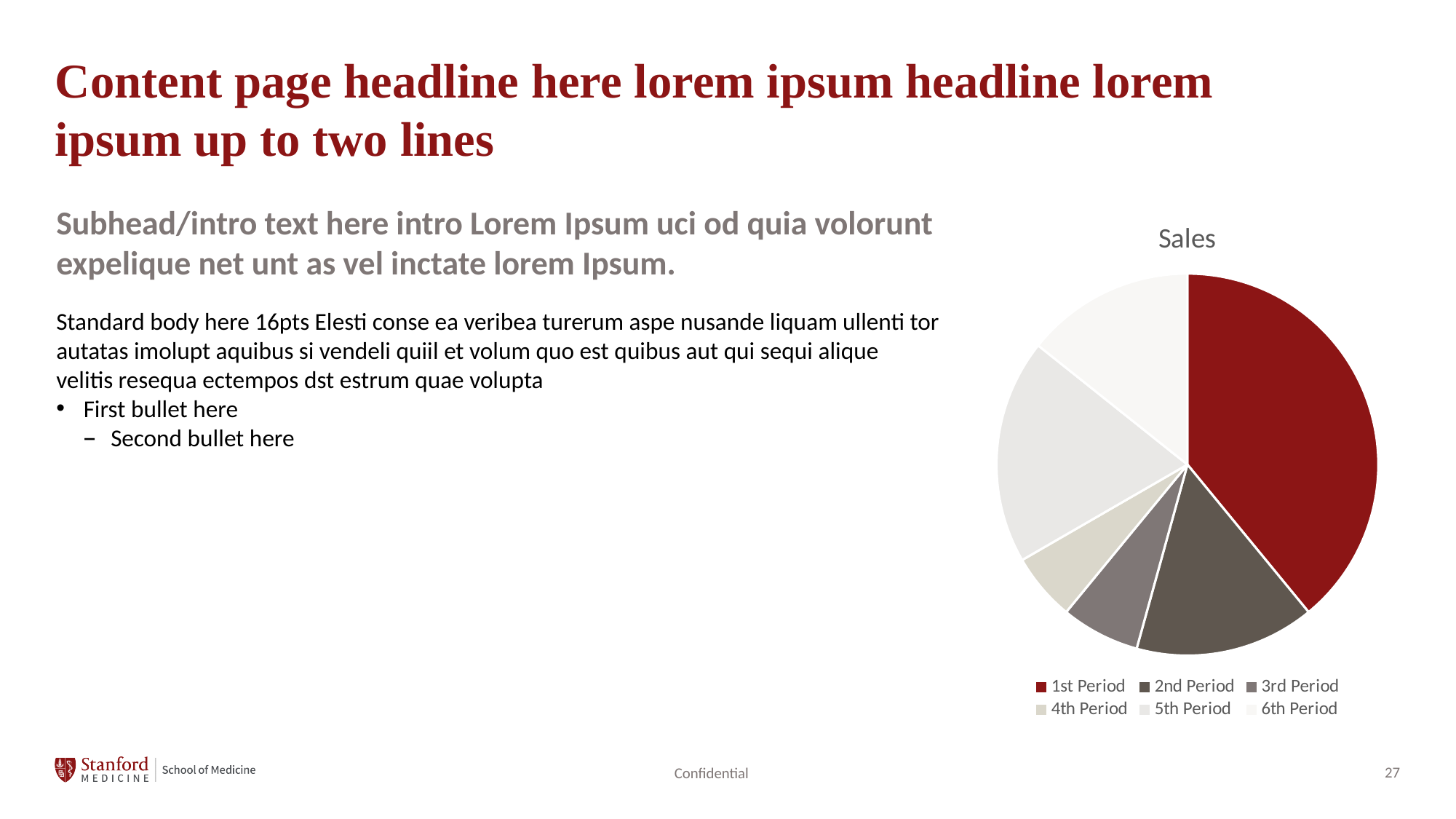
Which period has the largest slice of the pie? 1st Period Which slice is larger, 6th Period or 3rd Period? 6th Period Which slice is larger, 5th Period or 4th Period? 5th Period Which slice is larger, 1st Period or 2nd Period? 1st Period How many slices does the pie chart have? 6 What colour is the 1st Period slice? dark red How many entries does the chart legend list? 6 What is the title of the chart? Sales What kind of chart is shown on the slide? pie chart